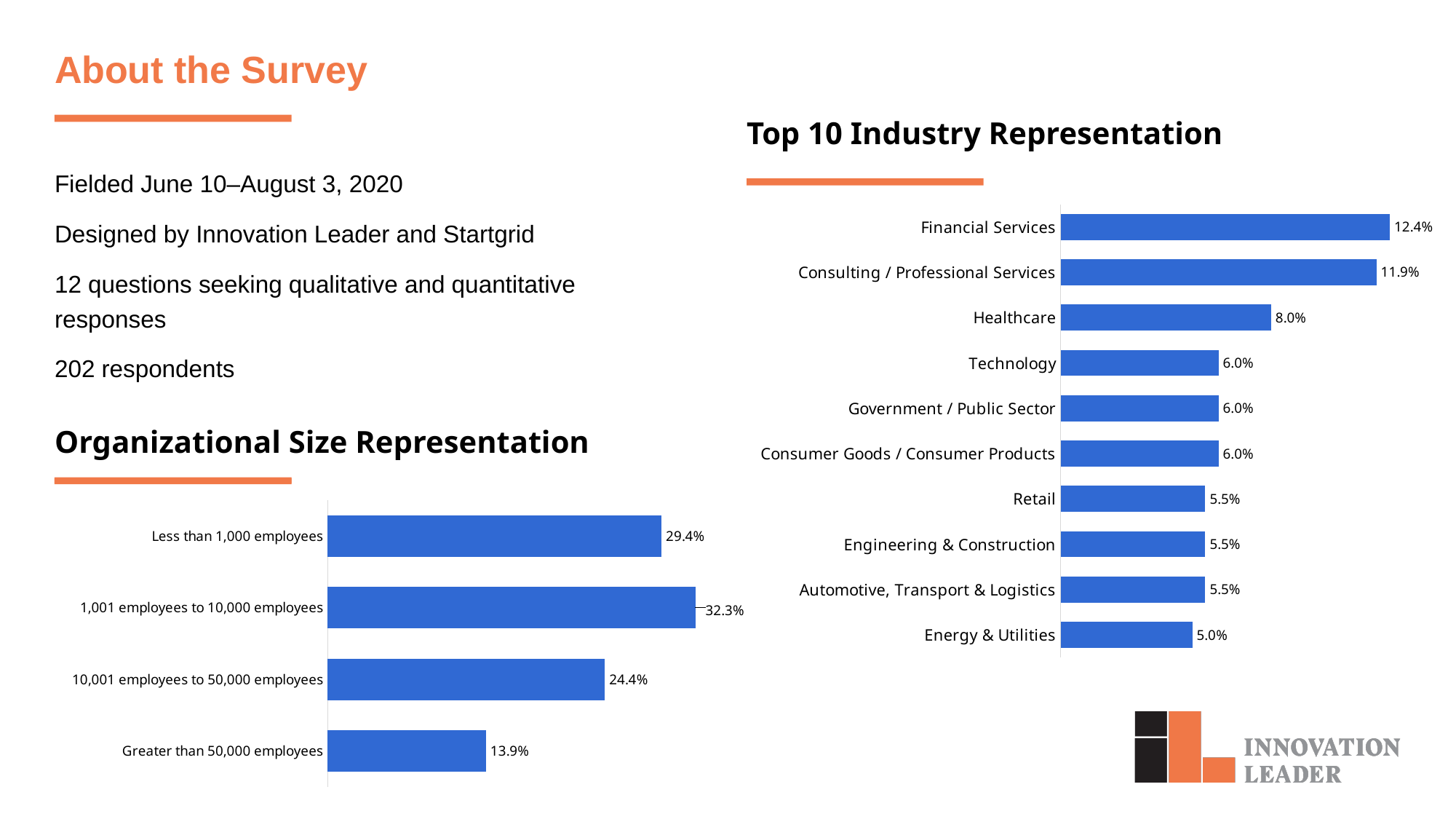
In the Top 10 Industry Representation chart, which industry has the lowest value? Energy & Utilities In the Top 10 Industry Representation chart, what is the value for Healthcare? 8.0% In the Organizational Size Representation chart, what is the value for 1,001 employees to 10,000 employees? 32.3% In the Top 10 Industry Representation chart, which is larger, Healthcare or Technology? Healthcare In the Organizational Size Representation chart, which category has the lowest value? Greater than 50,000 employees In the Organizational Size Representation chart, how many categories are shown? 4 In the Top 10 Industry Representation chart, how many industries are shown? 10 What type of chart is the Top 10 Industry Representation chart? Bar chart In the Top 10 Industry Representation chart, what is the value for Retail? 5.5% In the Top 10 Industry Representation chart, what is the difference between Financial Services and Consulting / Professional Services? 0.5% In the Organizational Size Representation chart, what is the difference between Less than 1,000 employees and Greater than 50,000 employees? 15.5% In the Top 10 Industry Representation chart, which industry has the highest value? Financial Services